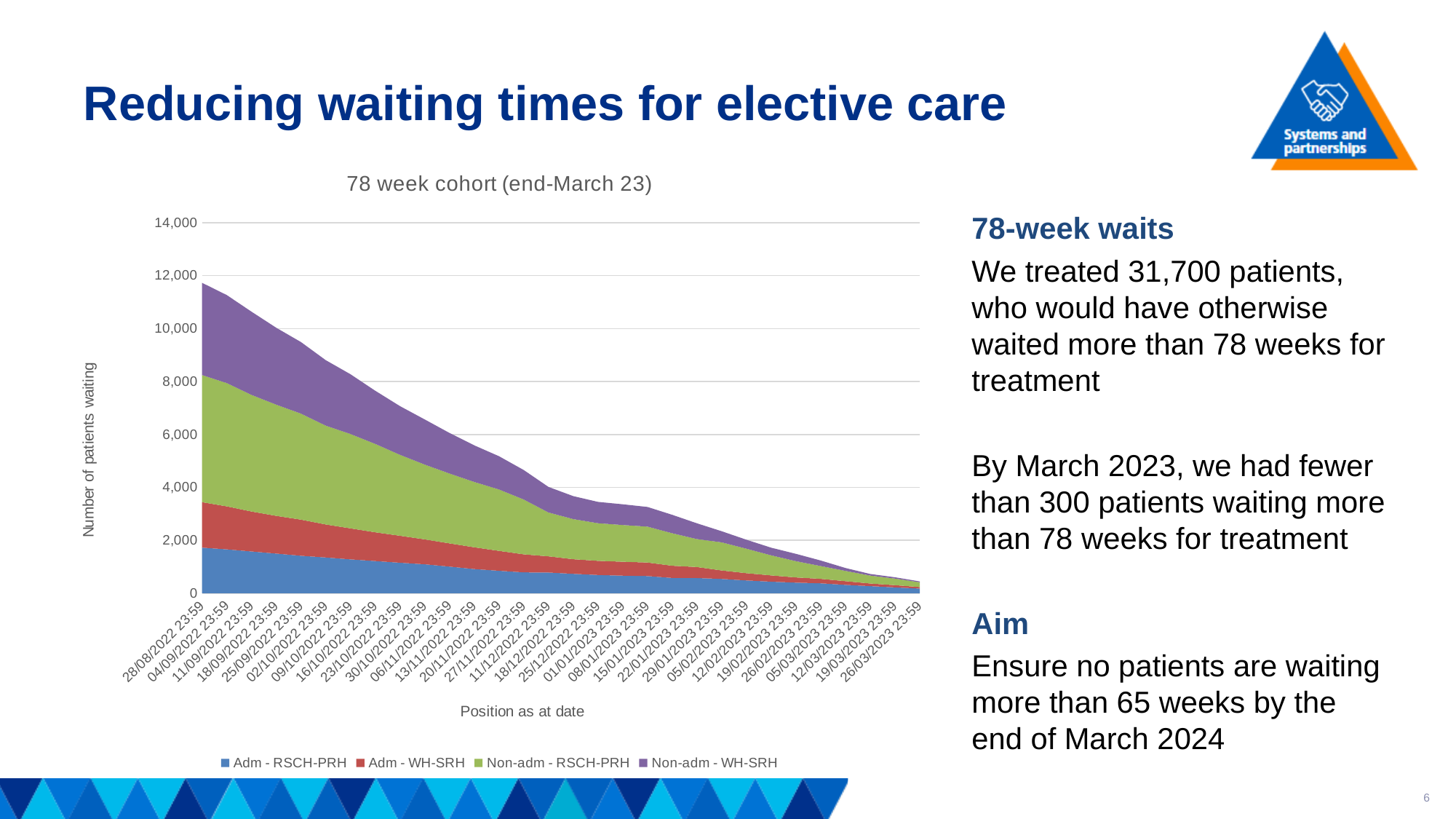
Does the total number of patients waiting rise or fall across the dates on the x axis? Fall On which date is the total number of patients waiting highest? 28/08/2022 23:59 How many series does the chart legend list? 4 What is the title of the chart? 78 week cohort (end-March 23) Is the total number of patients waiting at 01/01/2023 greater or less than 2,000? greater On which date is the total number of patients waiting lowest? 26/03/2023 23:59 Is the total number of patients waiting at 28/08/2022 greater or less than 10,000? greater Is the value for Adm - RSCH-PRH at 28/08/2022 greater or less than 2,000? less What kind of chart is shown on the slide? Stacked area chart What is the label of the vertical axis of the chart? Number of patients waiting At 28/08/2022, which series is larger: Non-adm - RSCH-PRH or Adm - WH-SRH? Non-adm - RSCH-PRH